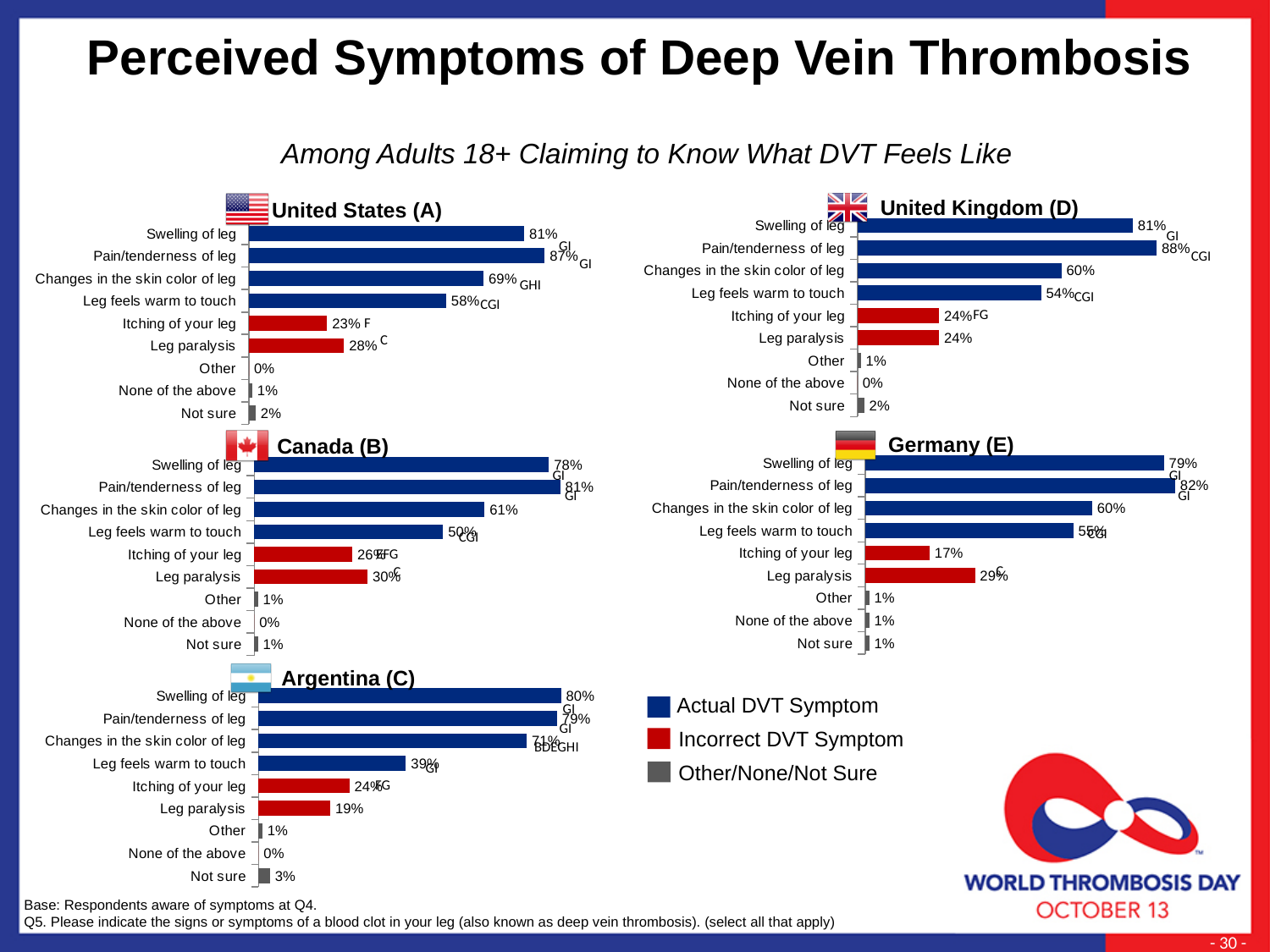
In the United States (A) chart, what percentage is shown for Pain/tenderness of leg? 87% How many categories are listed in the United States (A) chart? 9 In the Argentina (C) chart, what percentage is shown for Not sure? 3% In the Canada (B) chart, which is larger, Itching of your leg or Leg paralysis? Leg paralysis In the Germany (E) chart, what percentage is shown for Itching of your leg? 17% In the Germany (E) chart, what is the difference between Pain/tenderness of leg and Swelling of leg? 3 percentage points In the United Kingdom (D) chart, what percentage is shown for Changes in the skin color of leg? 60% In the United Kingdom (D) chart, which symptom has the highest percentage? Pain/tenderness of leg How many entries does the legend on the slide list? 3 In the Argentina (C) chart, what is the difference between Swelling of leg and Leg feels warm to touch? 41 percentage points What type of chart is used for the United Kingdom (D) data? Bar chart According to the legend, what colour represents an Incorrect DVT Symptom? Red